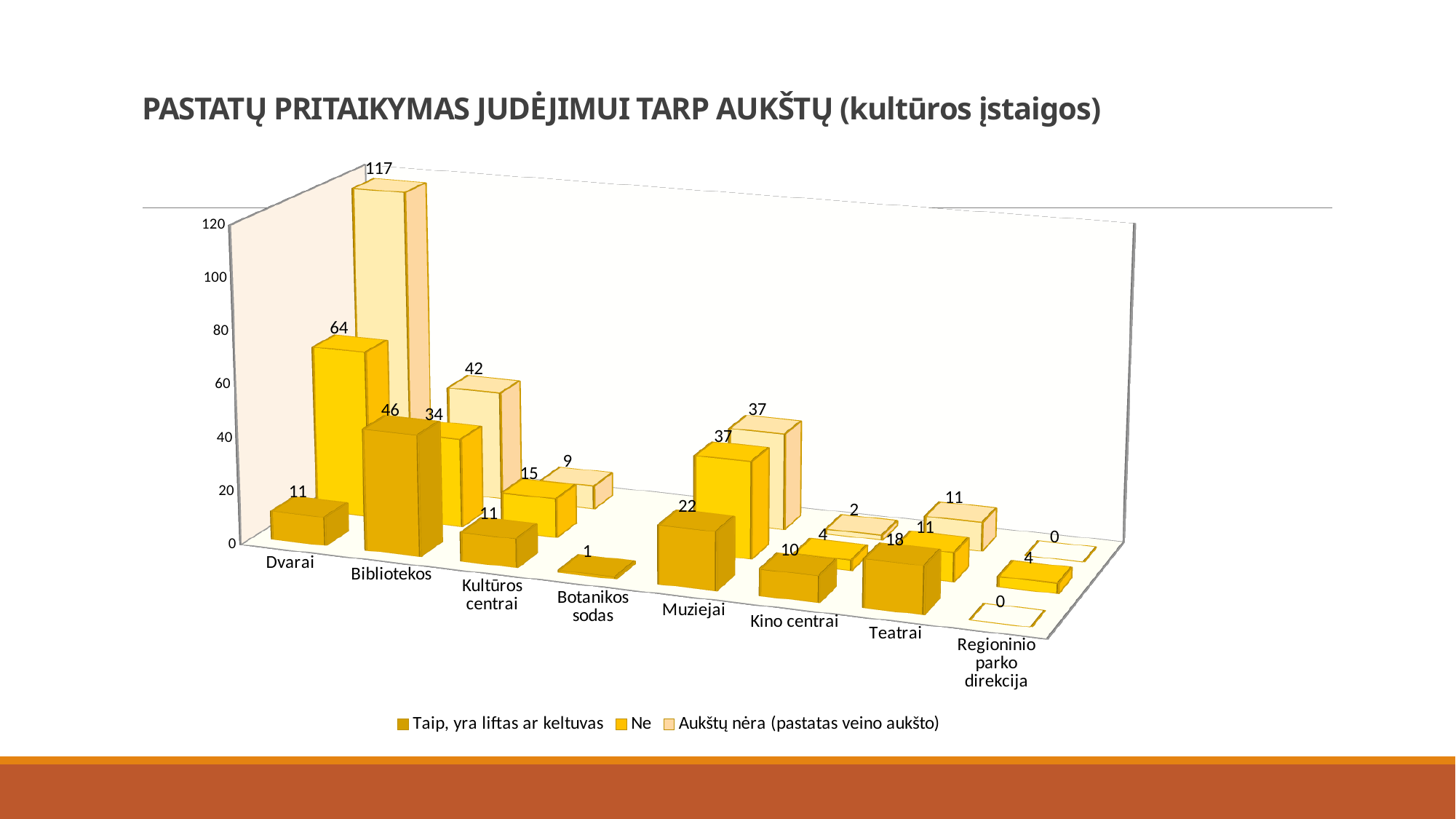
What is the value of "Aukštų nėra (pastatas veino aukšto)" for Dvarai? 117 What is the value of "Taip, yra liftas ar keltuvas" for Bibliotekos? 46 What kind of chart is shown on the slide? Bar chart How many series does the legend list? 3 What is the value of "Taip, yra liftas ar keltuvas" for Muziejai? 22 How many categories are shown on the x axis? 8 What is the value of "Ne" for Dvarai? 64 What is the title of the chart? PASTATŲ PRITAIKYMAS JUDĖJIMUI TARP AUKŠTŲ (kultūros įstaigos) What is the difference between the "Ne" values for Dvarai and Bibliotekos? 30 Which category has the highest value for "Aukštų nėra (pastatas veino aukšto)"? Dvarai Which category has the highest value for "Taip, yra liftas ar keltuvas"? Bibliotekos Which is larger: the "Taip, yra liftas ar keltuvas" value for Teatrai or for Kino centrai? Teatrai